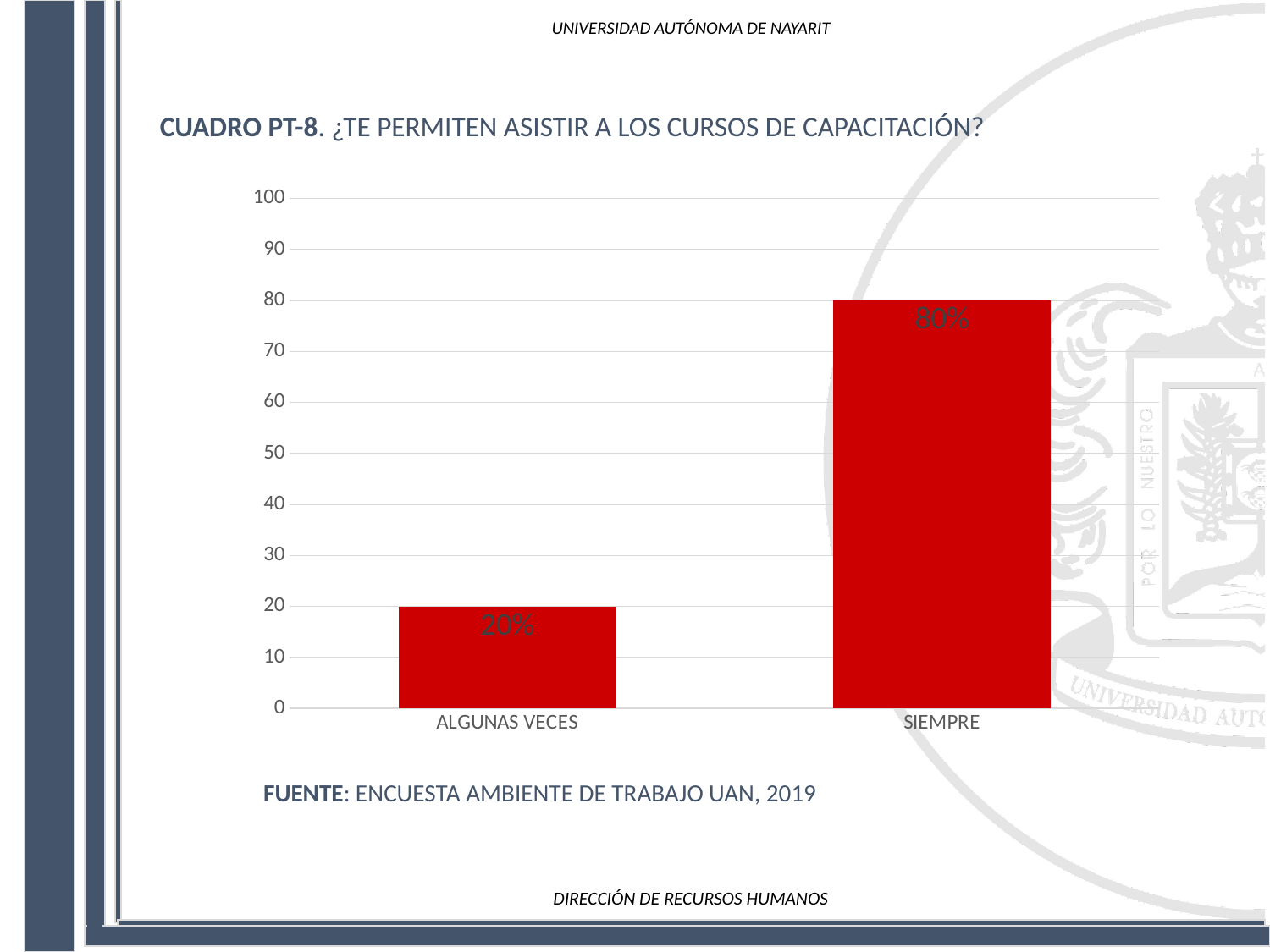
How many categories are shown on the x axis? 2 Which is larger, the value for ALGUNAS VECES or the value for SIEMPRE? SIEMPRE What is the title of the chart? CUADRO PT-8. ¿TE PERMITEN ASISTIR A LOS CURSOS DE CAPACITACIÓN? What is the value for SIEMPRE? 80% What is the value for ALGUNAS VECES? 20% Is the value for ALGUNAS VECES greater or less than 30? less Which category has the highest value? SIEMPRE What is the difference between the values for SIEMPRE and ALGUNAS VECES? 60% What is the source cited below the chart? ENCUESTA AMBIENTE DE TRABAJO UAN, 2019 Which category has the lowest value? ALGUNAS VECES Is the value for SIEMPRE greater or less than 50? greater What kind of chart is shown on the slide? bar chart